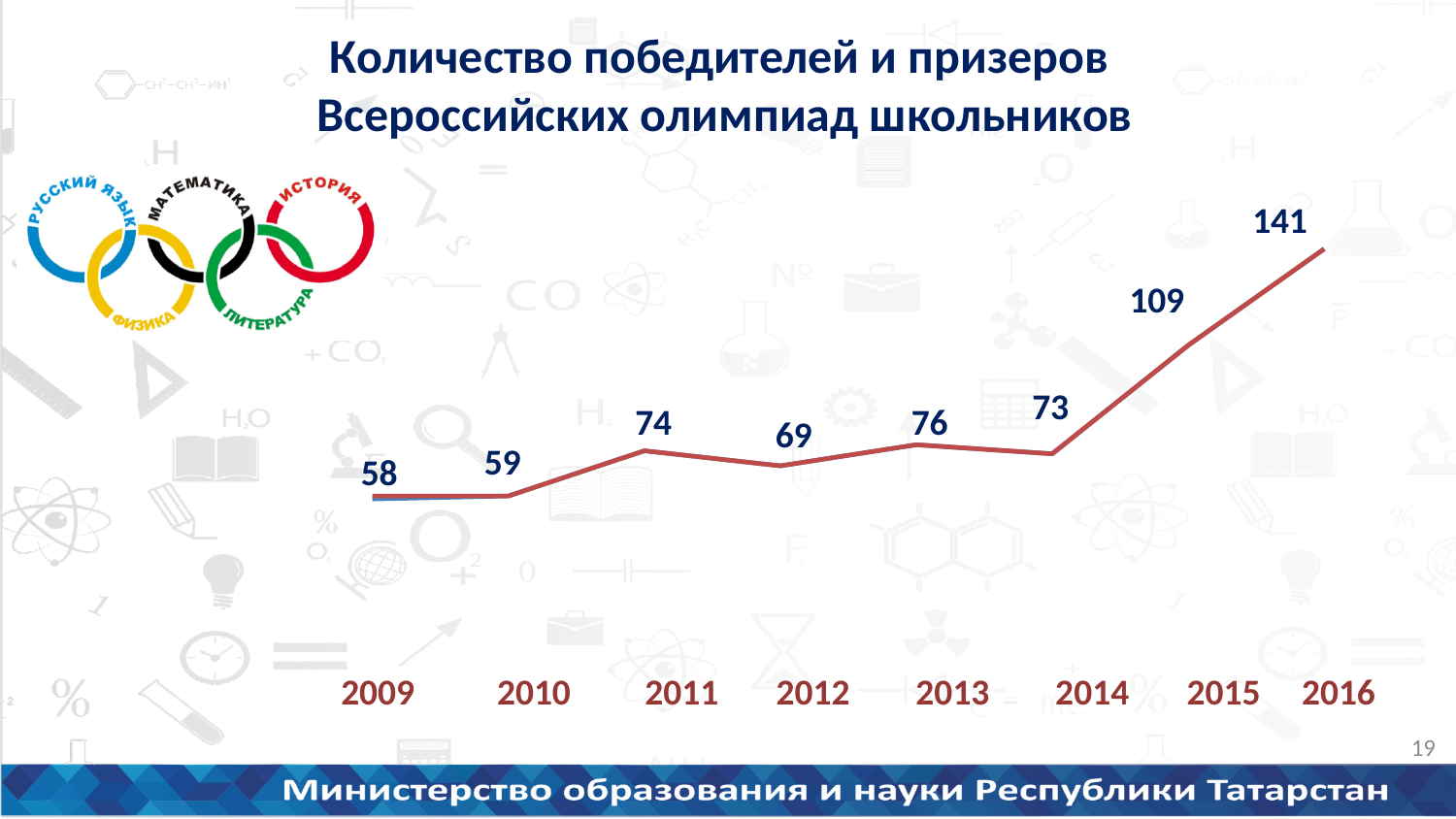
Which year has the highest value? 2016 Which year has a larger value, 2013 or 2014? 2013 What value is shown for 2013? 76 What is the title of the chart? Количество победителей и призеров Всероссийских олимпиад школьников What was the number of winners and prize-holders in 2016? 141 Does the value rise or fall from 2014 to 2016? rise What is the difference between the values for 2016 and 2015? 32 How many years are plotted on the chart? 8 What value is shown for 2009? 58 Which year has the lowest value? 2009 What is the difference between the values for 2011 and 2012? 5 What type of chart is shown on the slide? line chart